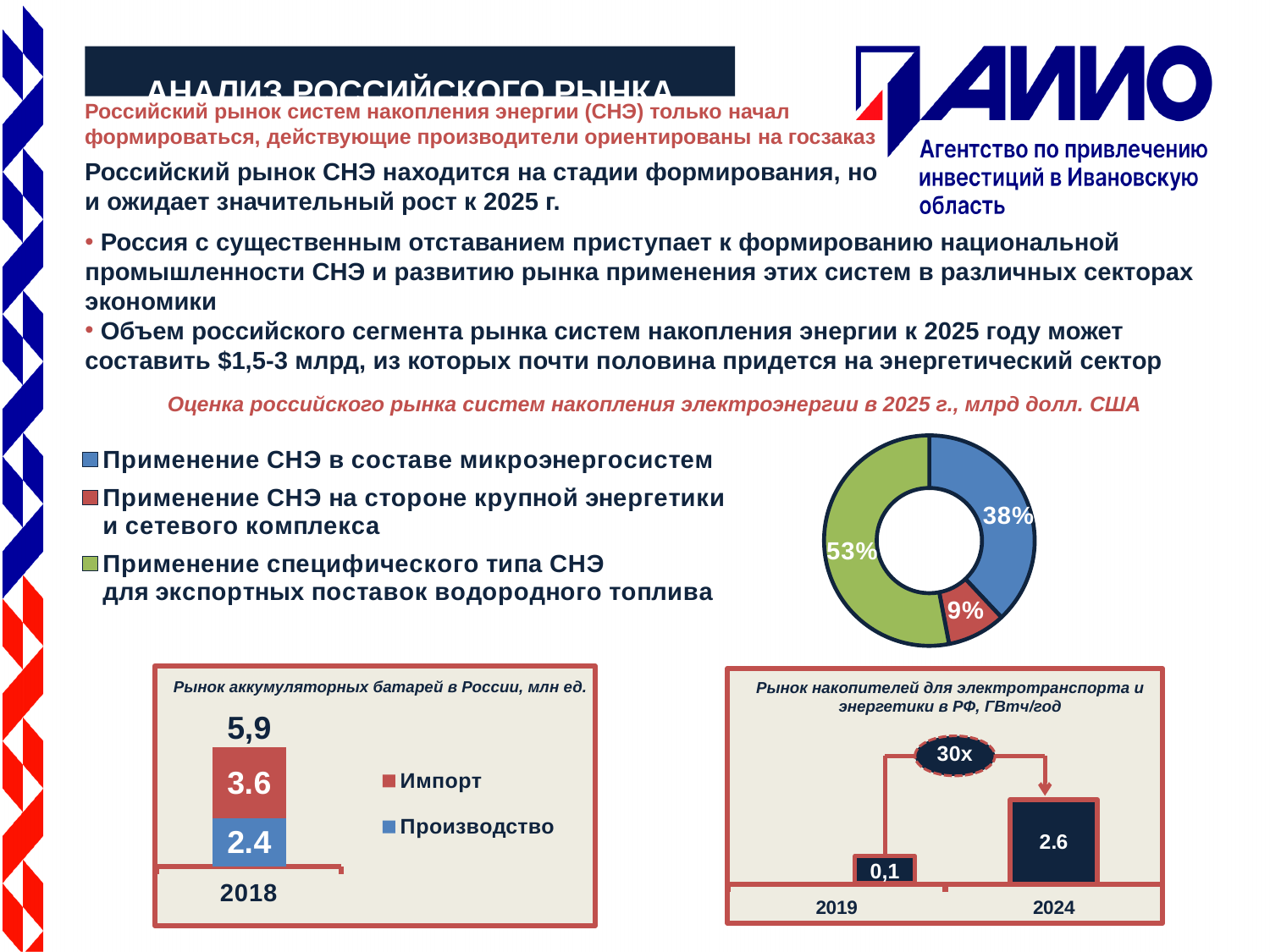
In the chart 'Рынок накопителей для электротранспорта и энергетики в РФ, ГВтч/год', what is the value for 2024? 2.6 In the chart 'Рынок накопителей для электротранспорта и энергетики в РФ, ГВтч/год', what is the value for 2019? 0,1 In the doughnut chart 'Оценка российского рынка систем накопления электроэнергии в 2025 г.', what share is shown for 'Применение специфического типа СНЭ для экспортных поставок водородного топлива'? 53% In the doughnut chart 'Оценка российского рынка систем накопления электроэнергии в 2025 г.', which category has the smallest share? Применение СНЭ на стороне крупной энергетики и сетевого комплекса How many categories does the legend of the doughnut chart 'Оценка российского рынка систем накопления электроэнергии в 2025 г.' list? 3 In the chart 'Рынок аккумуляторных батарей в России, млн ед.', what is the value for Производство in 2018? 2.4 In the doughnut chart 'Оценка российского рынка систем накопления электроэнергии в 2025 г.', what share is shown for 'Применение СНЭ на стороне крупной энергетики и сетевого комплекса'? 9% In the chart 'Рынок аккумуляторных батарей в России, млн ед.', what is the total of the stacked bar for 2018? 5,9 In the doughnut chart 'Оценка российского рынка систем накопления электроэнергии в 2025 г.', which category has the largest share? Применение специфического типа СНЭ для экспортных поставок водородного топлива In the chart 'Рынок аккумуляторных батарей в России, млн ед.', what is the value for Импорт in 2018? 3.6 In the doughnut chart 'Оценка российского рынка систем накопления электроэнергии в 2025 г.', what share is shown for 'Применение СНЭ в составе микроэнергосистем'? 38% In the chart 'Рынок аккумуляторных батарей в России, млн ед.', which is larger in 2018, Импорт or Производство? Импорт